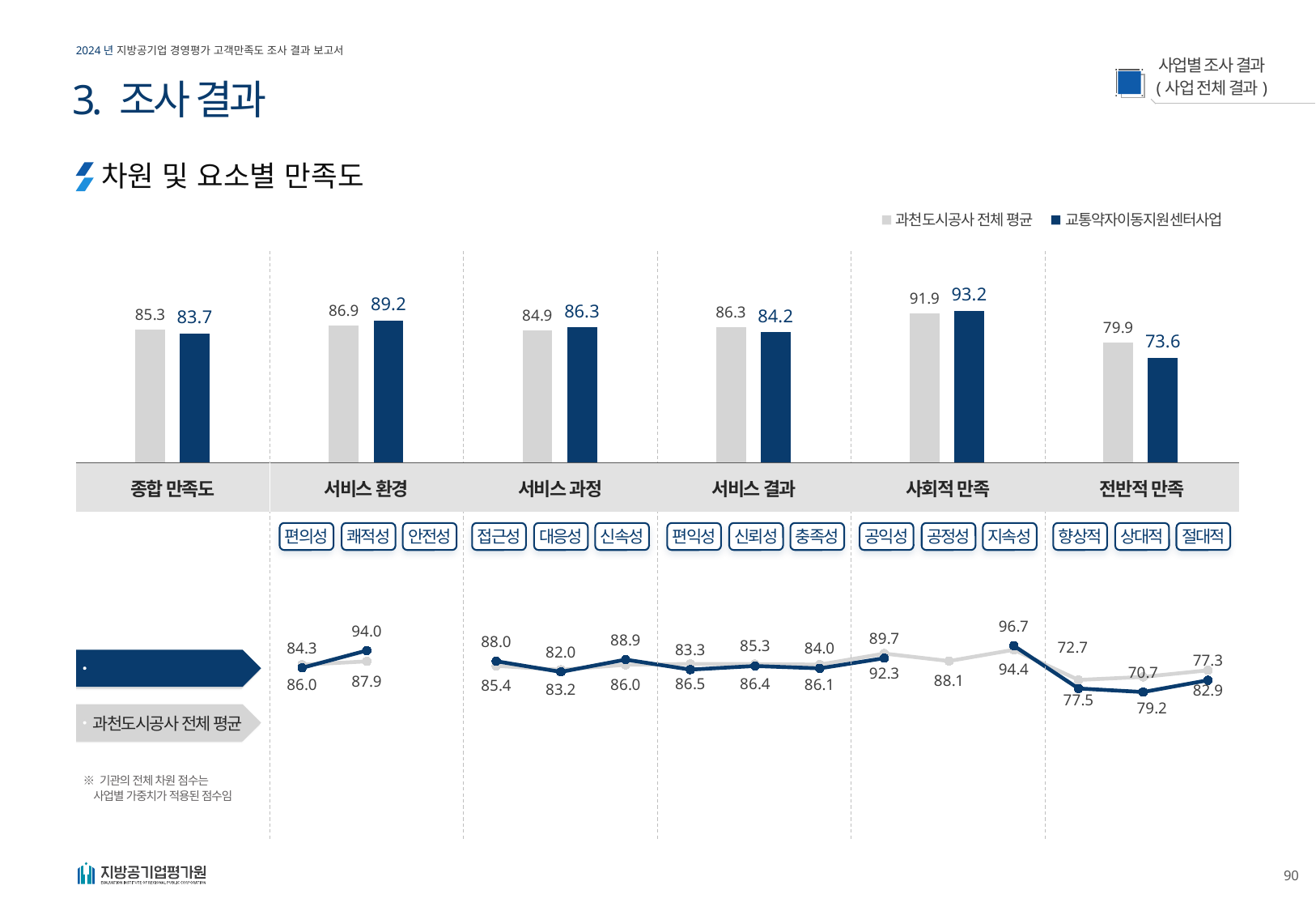
In the bar chart, what is the difference between 과천도시공사 전체 평균 and 교통약자이동지원센터사업 for 전반적 만족? 6.3 How many categories are shown in the bar chart? 6 In the bar chart, for 서비스 결과, which series has the larger value: 과천도시공사 전체 평균 or 교통약자이동지원센터사업? 과천도시공사 전체 평균 In the bar chart, what is the value of 교통약자이동지원센터사업 for 사회적 만족? 93.2 In the lower line chart, which element has the highest labeled value? 지속성 What kind of chart is the upper chart on the slide? bar chart In the bar chart, what is the value of 교통약자이동지원센터사업 for 종합 만족도? 83.7 In the bar chart, what is the value of 과천도시공사 전체 평균 for 전반적 만족? 79.9 In the bar chart, which category has the lowest value for 교통약자이동지원센터사업? 전반적 만족 How many element labels (e.g. 편의성, 쾌적성) are shown along the lower line chart? 15 In the bar chart, which category has the highest value for 교통약자이동지원센터사업? 사회적 만족 How many series does the bar chart legend list? 2